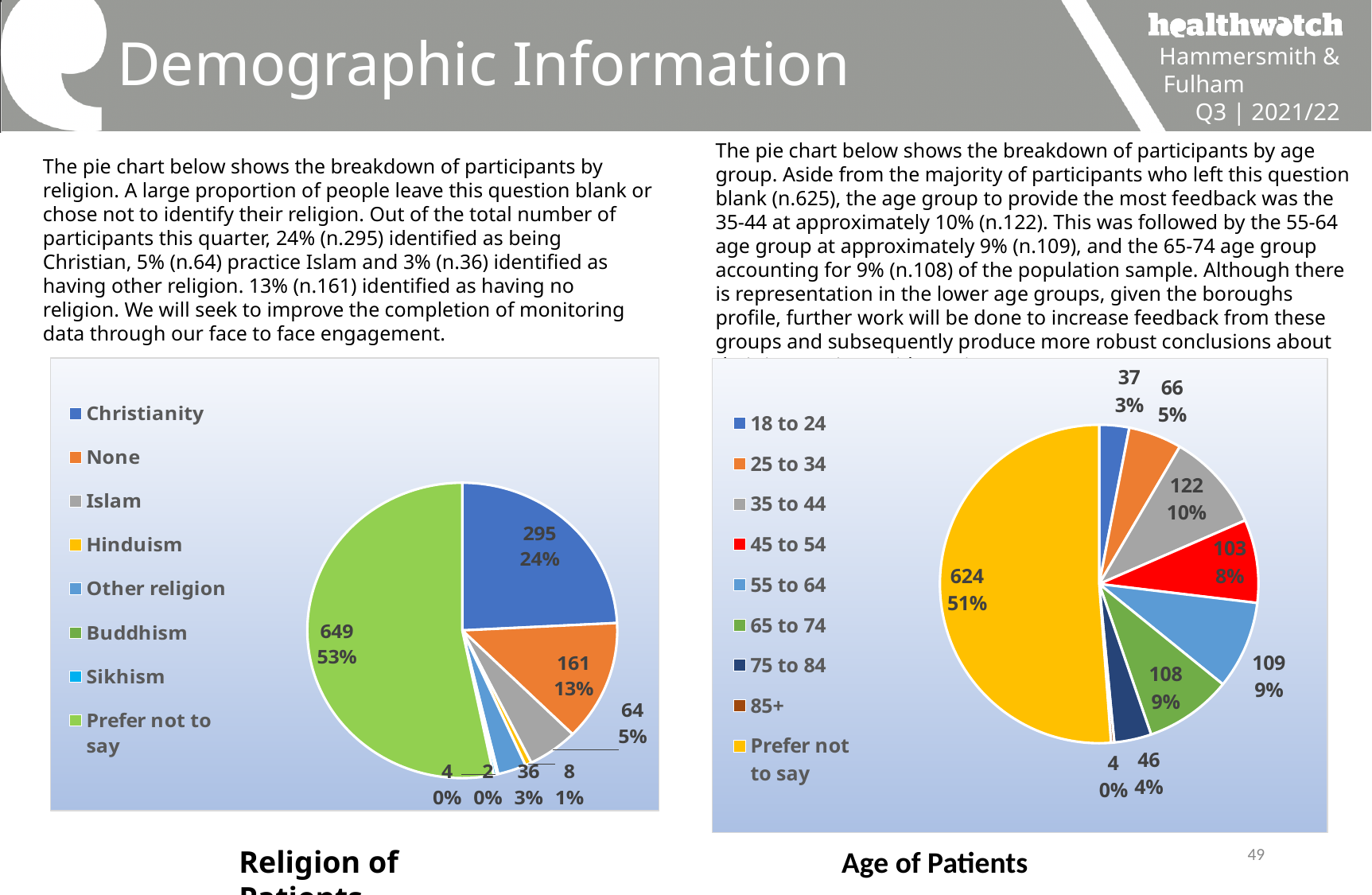
In the Age of Patients pie chart, what is the difference between the 55 to 64 count and the 75 to 84 count? 63 In the Age of Patients pie chart, how many participants are in the 35 to 44 age group? 122 In the Age of Patients pie chart, what percentage share does the Prefer not to say category have? 51% In the Religion of Patients pie chart, what is the difference between the Christianity count and the None count? 134 In the Age of Patients pie chart, how many categories does the legend list? 9 In the Age of Patients pie chart, which is larger: the 45 to 54 group or the 25 to 34 group? 45 to 54 In the Age of Patients pie chart, which age group has the smallest slice? 85+ What type of chart is the Religion of Patients chart? Pie chart In the Religion of Patients pie chart, what percentage share does the None category have? 13% In the Religion of Patients pie chart, which category has the largest slice? Prefer not to say In the Religion of Patients pie chart, how many categories does the legend list? 8 In the Religion of Patients pie chart, how many participants identified as Christianity? 295